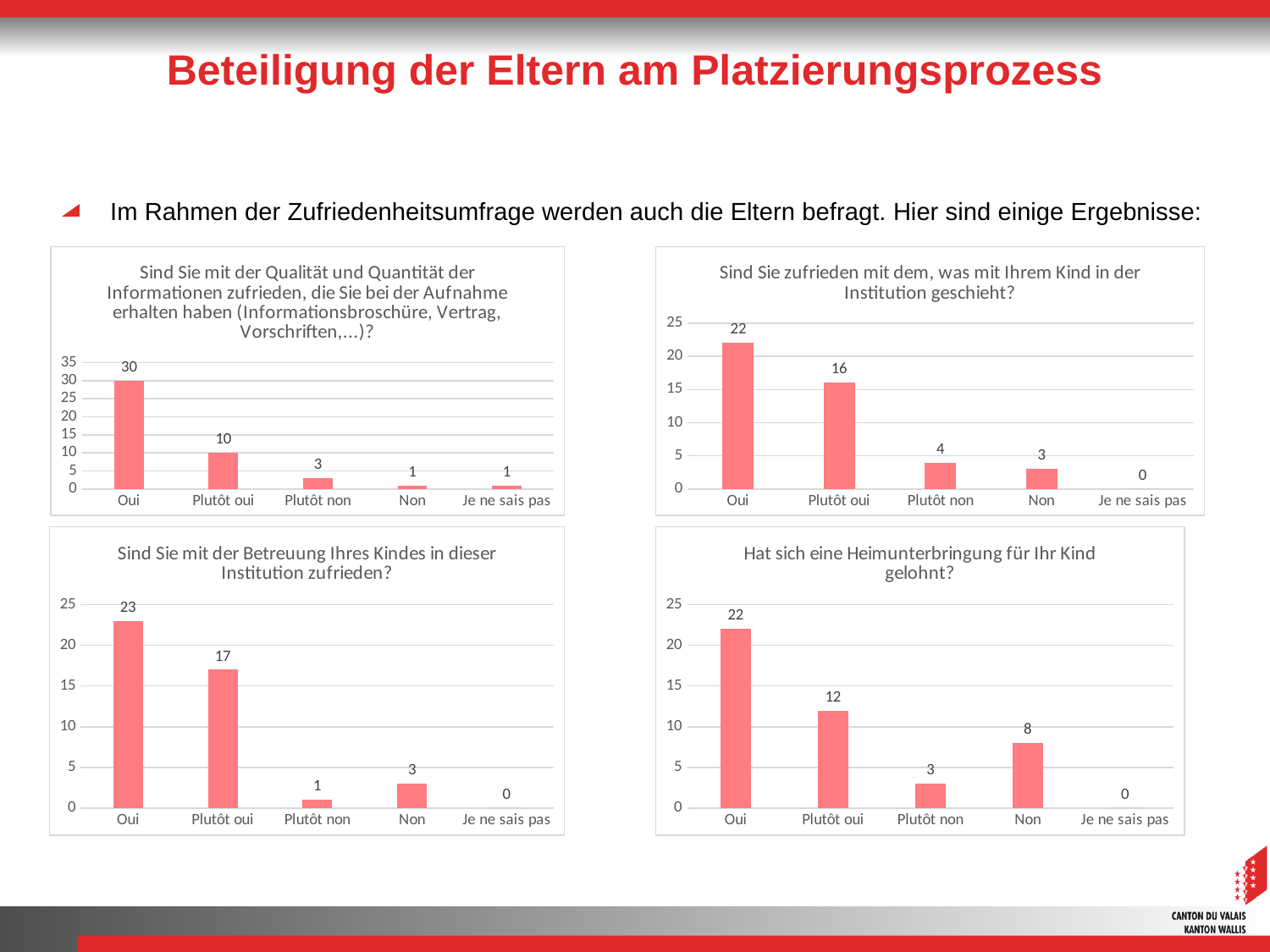
In the top-right chart "Sind Sie zufrieden mit dem, was mit Ihrem Kind in der Institution geschieht?", which category has the highest value? Oui What type of chart is the bottom-left chart "Sind Sie mit der Betreuung Ihres Kindes in dieser Institution zufrieden?"? Bar chart In the bottom-left chart "Sind Sie mit der Betreuung Ihres Kindes in dieser Institution zufrieden?", what is the value for "Non"? 3 How many categories are shown on the x axis of the bottom-right chart "Hat sich eine Heimunterbringung für Ihr Kind gelohnt?"? 5 In the top-right chart "Sind Sie zufrieden mit dem, was mit Ihrem Kind in der Institution geschieht?", what is the value for "Je ne sais pas"? 0 In the top-left chart (about the quality and quantity of information received at admission), which category has the lowest value? Non and Je ne sais pas (both 1) In the bottom-right chart "Hat sich eine Heimunterbringung für Ihr Kind gelohnt?", what is the difference between "Oui" and "Plutôt oui"? 10 In the top-left chart (about the quality and quantity of information received at admission), what is the difference between "Oui" and "Plutôt oui"? 20 In the bottom-right chart "Hat sich eine Heimunterbringung für Ihr Kind gelohnt?", what is the value for "Non"? 8 In the bottom-left chart "Sind Sie mit der Betreuung Ihres Kindes in dieser Institution zufrieden?", which is larger, "Oui" or "Plutôt oui"? Oui In the top-left chart (about the quality and quantity of information received at admission), what is the value for "Oui"? 30 In the top-right chart "Sind Sie zufrieden mit dem, was mit Ihrem Kind in der Institution geschieht?", what is the value for "Plutôt oui"? 16